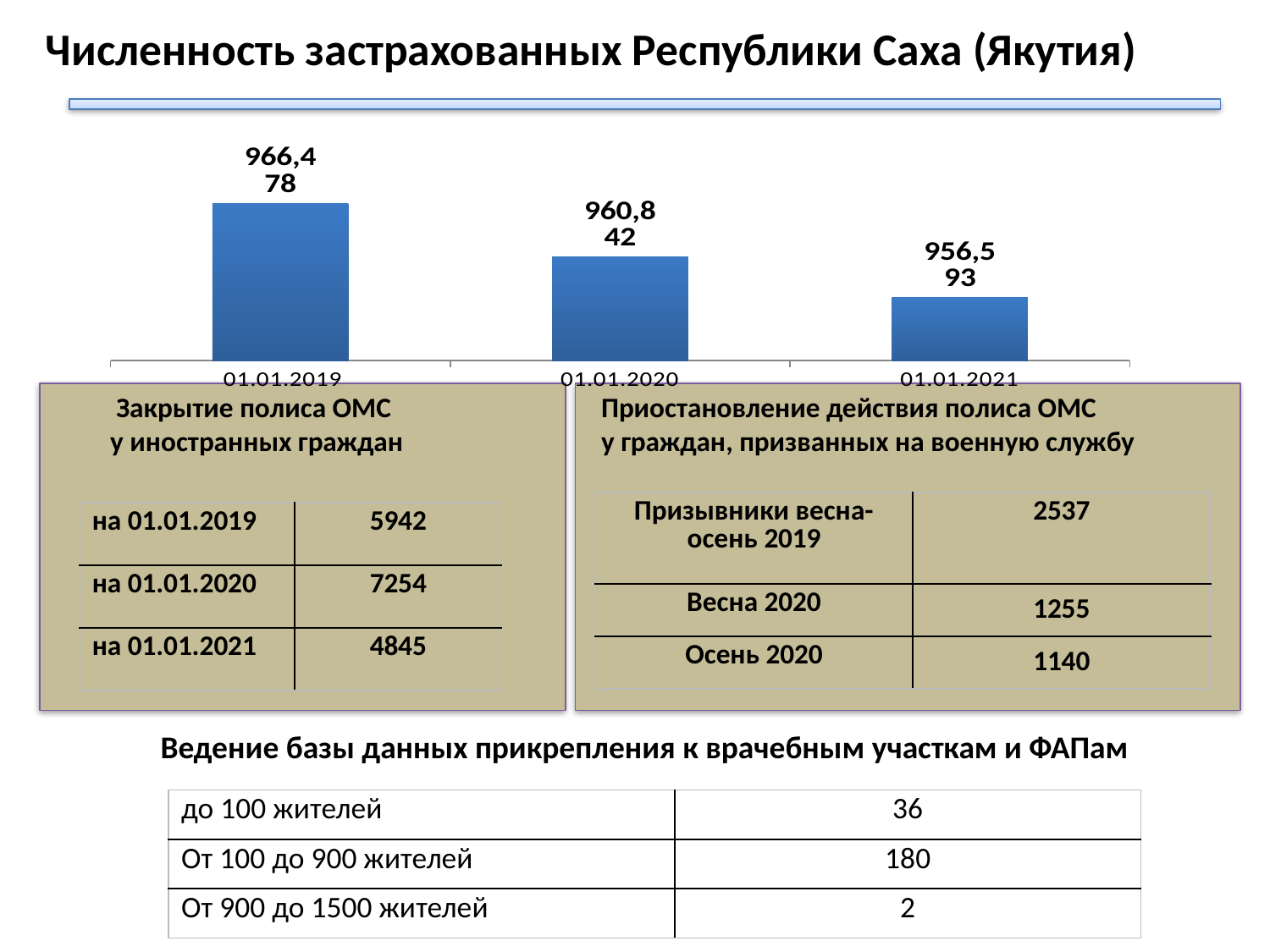
Do the values rise or fall from 01.01.2019 to 01.01.2021? fall What is the title of the slide above the chart? Численность застрахованных Республики Саха (Якутия) Which is larger, the value for 01.01.2020 or the value for 01.01.2021? 01.01.2020 Which date has the highest value in the chart? 01.01.2019 What is the value shown for 01.01.2019? 966,478 What is the difference between the values for 01.01.2019 and 01.01.2020? 5,636 What is the value shown for 01.01.2021? 956,593 What is the value shown for 01.01.2020? 960,842 What kind of chart is shown on the slide? bar chart Which date has the lowest value in the chart? 01.01.2021 How many bars (dates) does the chart show? 3 What is the difference between the values for 01.01.2019 and 01.01.2021? 9,885